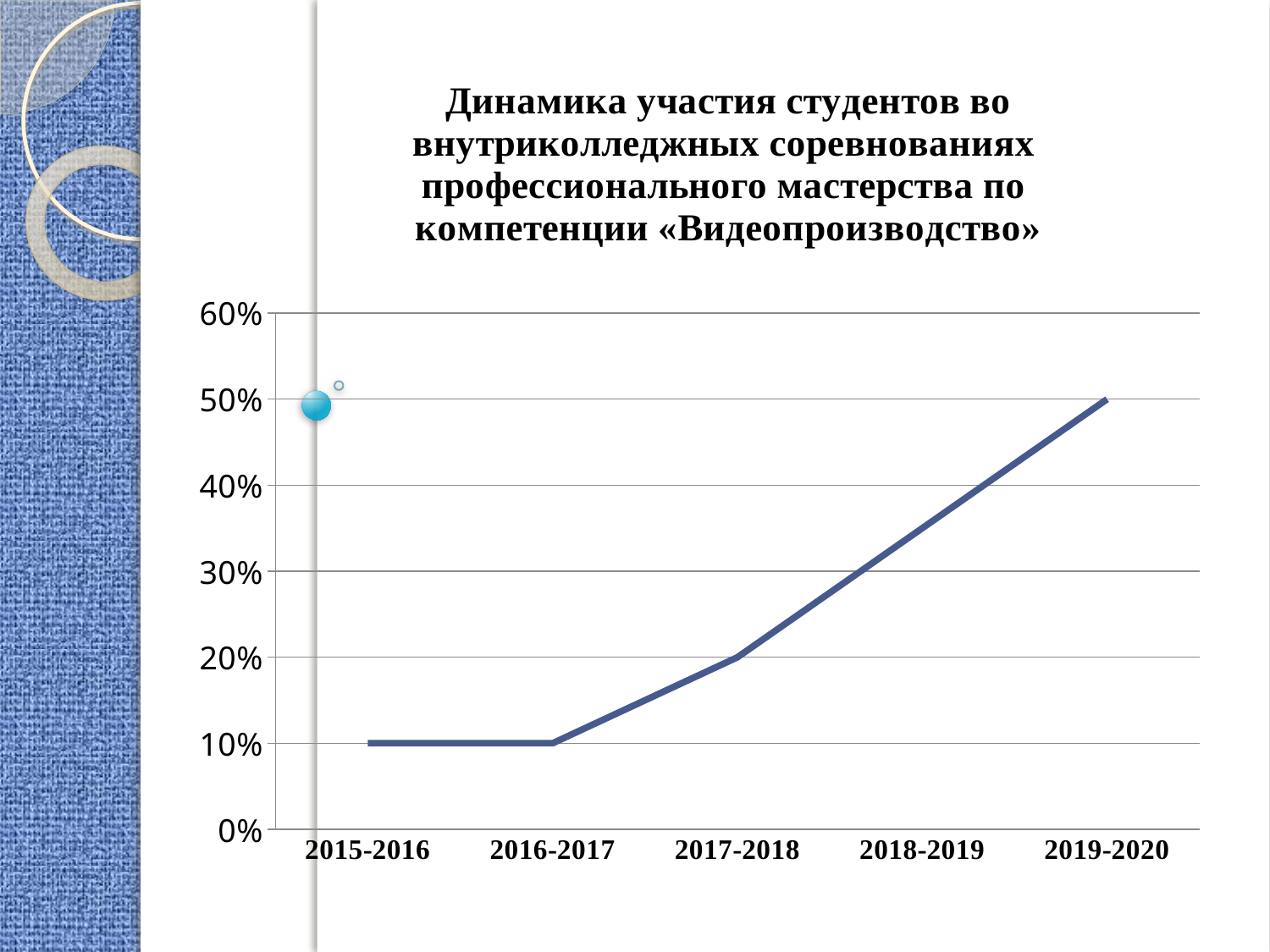
Which academic year has the highest value? 2019-2020 Which is larger, the value for 2017-2018 or the value for 2016-2017? 2017-2018 Is the value for 2018-2019 greater or less than 30%? greater What is the difference between the values for 2019-2020 and 2017-2018? 30% Is the value for 2018-2019 greater or less than 40%? less What is the maximum value shown on the y axis? 60% What is the value for 2015-2016? 10% What is the value for 2019-2020? 50% How many academic years are plotted on the x axis? 5 What type of chart is shown on the slide? line chart Do the values rise or fall from 2016-2017 to 2019-2020? rise What is the value for 2017-2018? 20%